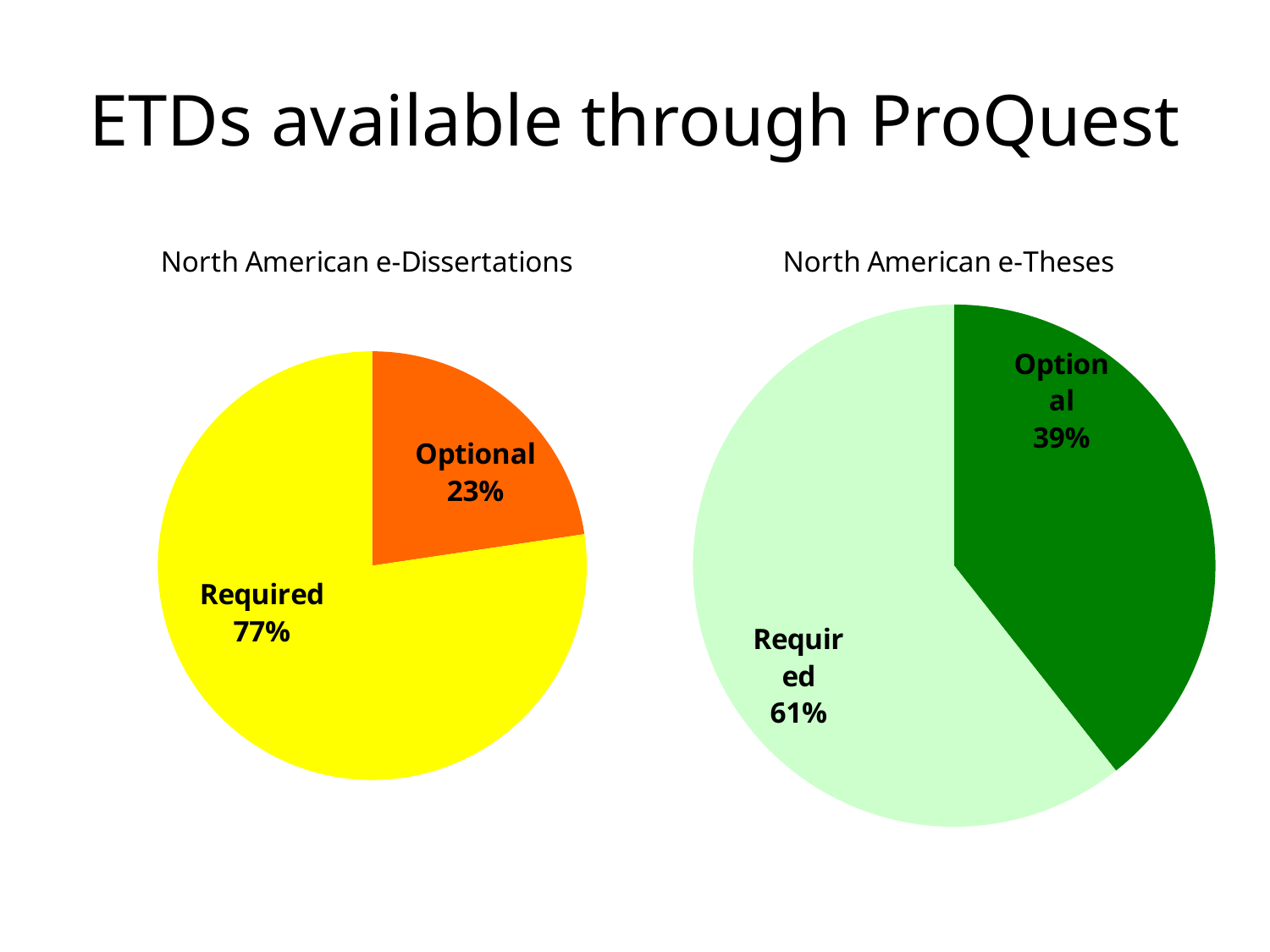
In the North American e-Dissertations chart, what share is labelled Required? 77% In the North American e-Theses chart, what is the difference between the Required and Optional shares? 22% In the North American e-Dissertations chart, what is the difference between the Required and Optional shares? 54% What is the title of the slide? ETDs available through ProQuest In the North American e-Theses chart, what share is labelled Required? 61% How many slices does the North American e-Theses chart have? 2 In the North American e-Dissertations chart, what share is labelled Optional? 23% In the North American e-Theses chart, what share is labelled Optional? 39% In the North American e-Theses chart, which slice is the smallest? Optional Which chart has the larger Optional share, North American e-Dissertations or North American e-Theses? North American e-Theses What kind of chart is the North American e-Dissertations chart? Pie chart In the North American e-Dissertations chart, which slice is the largest? Required